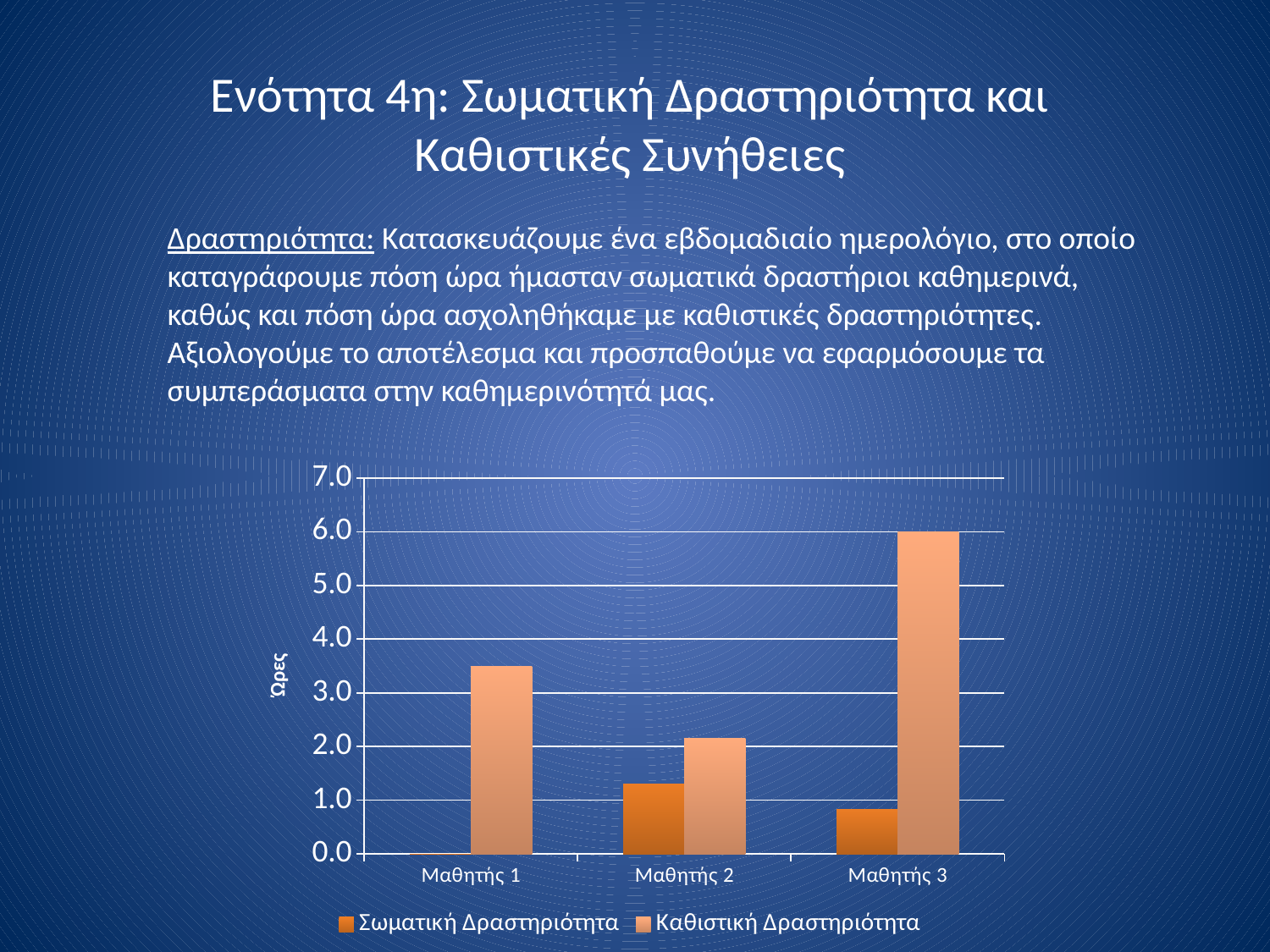
What is the label on the vertical axis of the chart? Ώρες Which student has the highest value for Καθιστική Δραστηριότητα? Μαθητής 3 For Μαθητής 2, which is larger: Σωματική Δραστηριότητα or Καθιστική Δραστηριότητα? Καθιστική Δραστηριότητα What kind of chart is shown on the slide? Bar chart Which student has the highest value for Σωματική Δραστηριότητα? Μαθητής 2 How many series does the legend list? 2 Is the Καθιστική Δραστηριότητα value for Μαθητής 3 greater or less than 5.0? greater Is the Σωματική Δραστηριότητα value for Μαθητής 3 greater or less than 1.0? less Which student has the lowest value for Καθιστική Δραστηριότητα? Μαθητής 2 Is the Καθιστική Δραστηριότητα value for Μαθητής 1 greater or less than 3.0? greater What are the two series named in the chart legend? Σωματική Δραστηριότητα and Καθιστική Δραστηριότητα How many categories (students) are shown on the x axis? 3